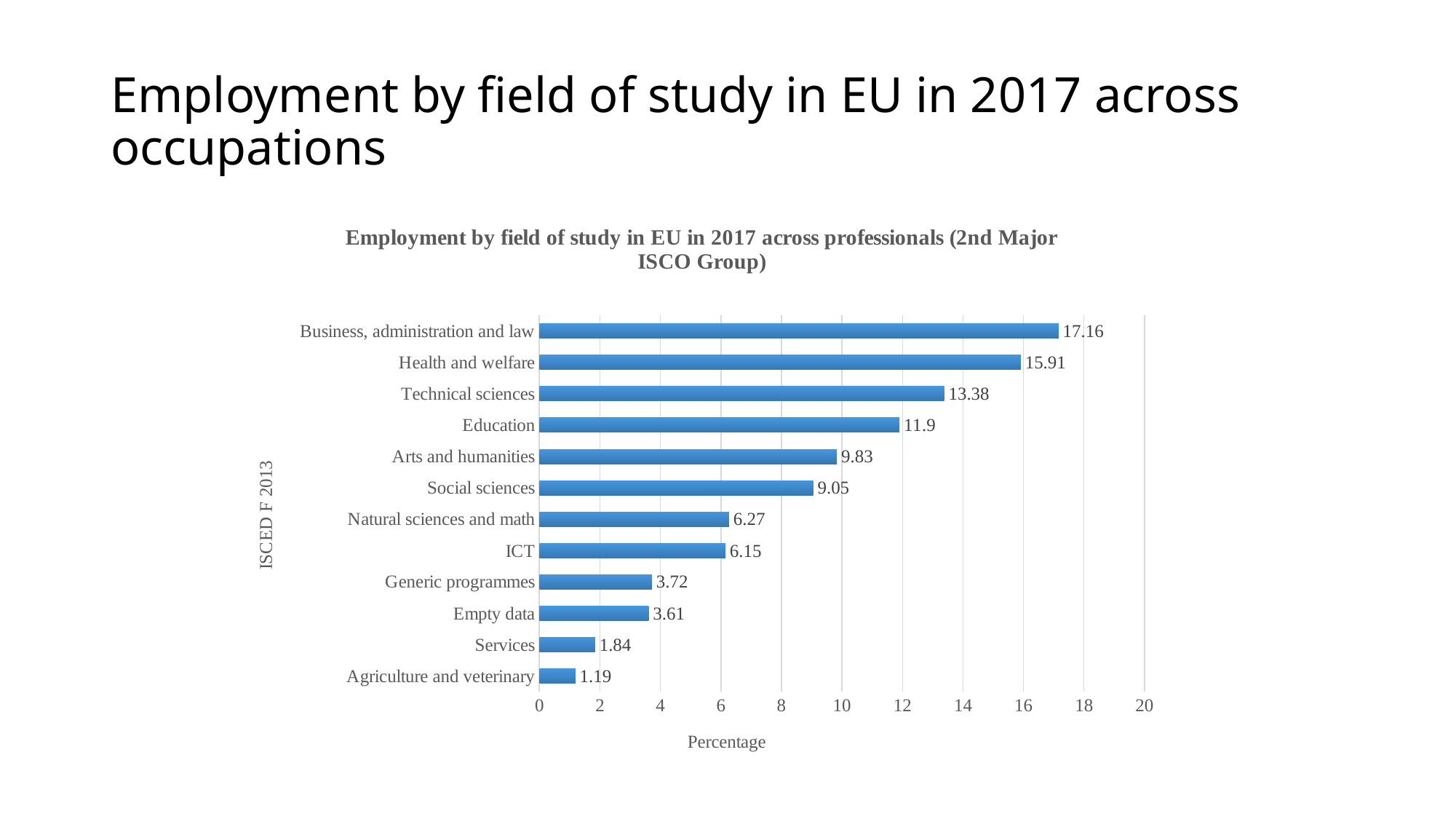
What is the value for Health and welfare? 15.91 What kind of chart is shown on the slide? Bar chart What is the value for ICT? 6.15 What is the value for Education? 11.9 What is the difference between the values for Technical sciences and Education? 1.48 Which field of study has the highest value? Business, administration and law Which field of study has the lowest value? Agriculture and veterinary What is the difference between the values for Business, administration and law and Health and welfare? 1.25 Is the value for Technical sciences greater or less than 12? greater What is the label of the horizontal axis? Percentage How many fields of study are shown in the chart? 12 Which is larger, the value for Arts and humanities or the value for Social sciences? Arts and humanities